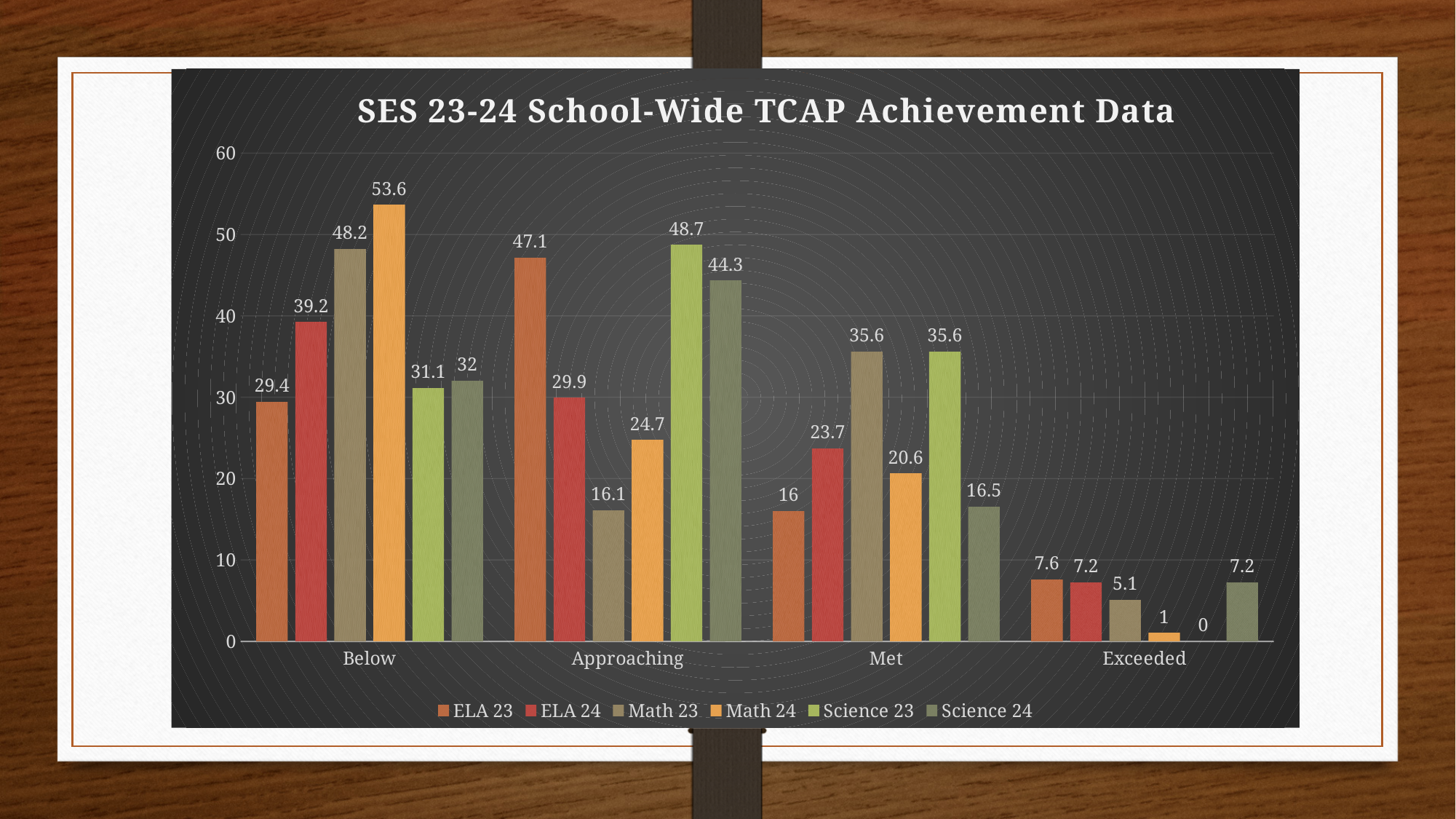
What is the value for Science 23 in the Approaching category? 48.7 What is the title of the chart? SES 23-24 School-Wide TCAP Achievement Data What is the value for ELA 24 in the Met category? 23.7 How many series does the legend list? 6 Which series has the lowest value in the Approaching category? Math 23 What is the difference between the ELA 23 and ELA 24 values in the Approaching category? 17.2 Which is larger in the Met category, Math 24 or ELA 24? ELA 24 What kind of chart is shown on the slide? Bar chart How many categories are shown on the x axis? 4 Which series has the highest value in the Below category? Math 24 What is the value for Math 24 in the Below category? 53.6 What is the value for Science 23 in the Exceeded category? 0